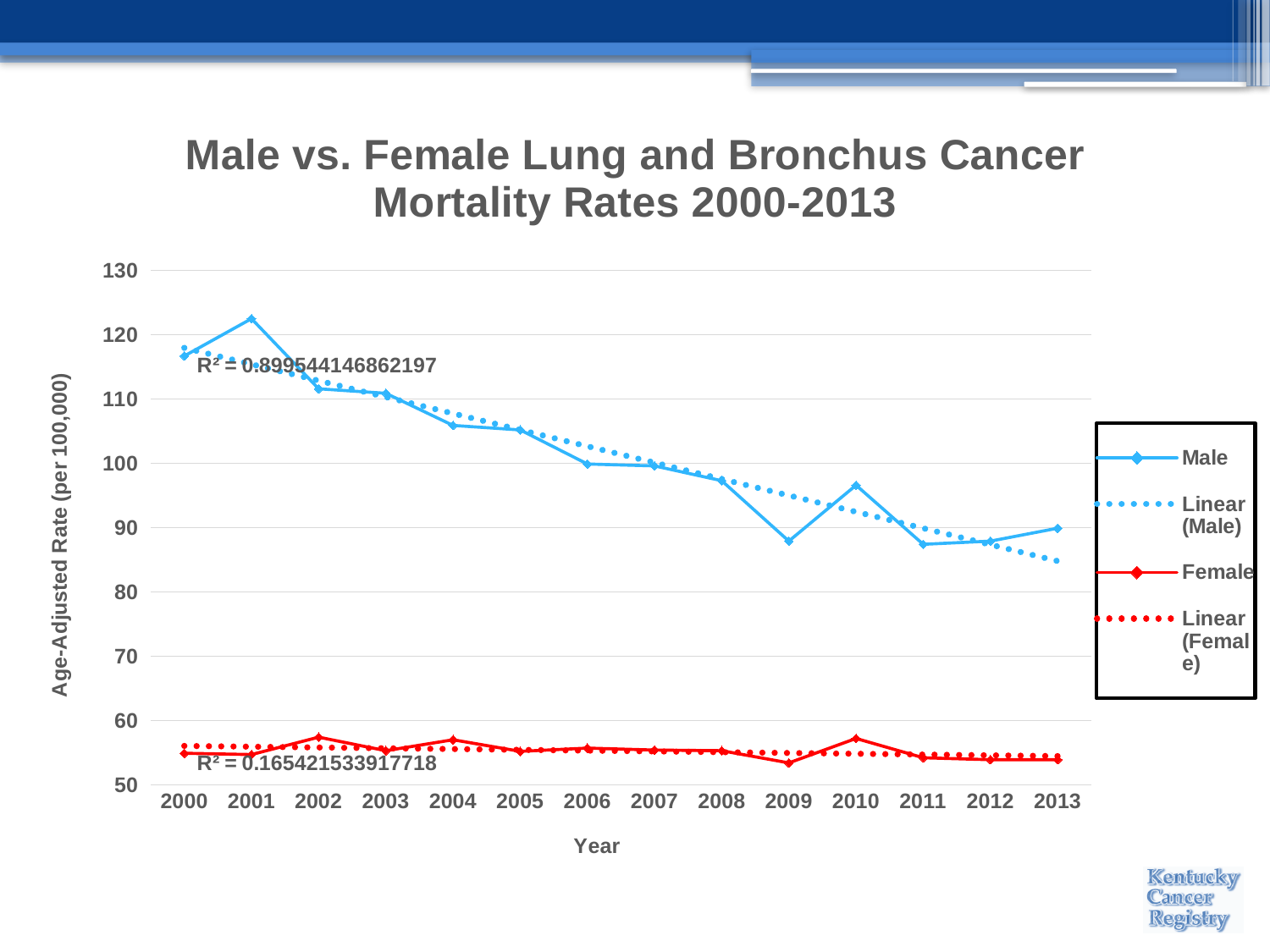
Which is larger in 2000, the Male rate or the Female rate? Male What R² value is shown for the Male linear trendline? 0.899544146862197 How many years are plotted along the x axis? 14 What is the label of the y axis? Age-Adjusted Rate (per 100,000) How many series does the legend list? 4 Does the Male mortality rate generally rise or fall from 2000 to 2013? fall Is the Male value for 2001 greater or less than 120? greater Is the Female value for 2010 greater or less than 60? less In which year is the Male mortality rate highest? 2001 Is the Male value for 2009 greater or less than 90? less What kind of chart is shown on the slide? line chart